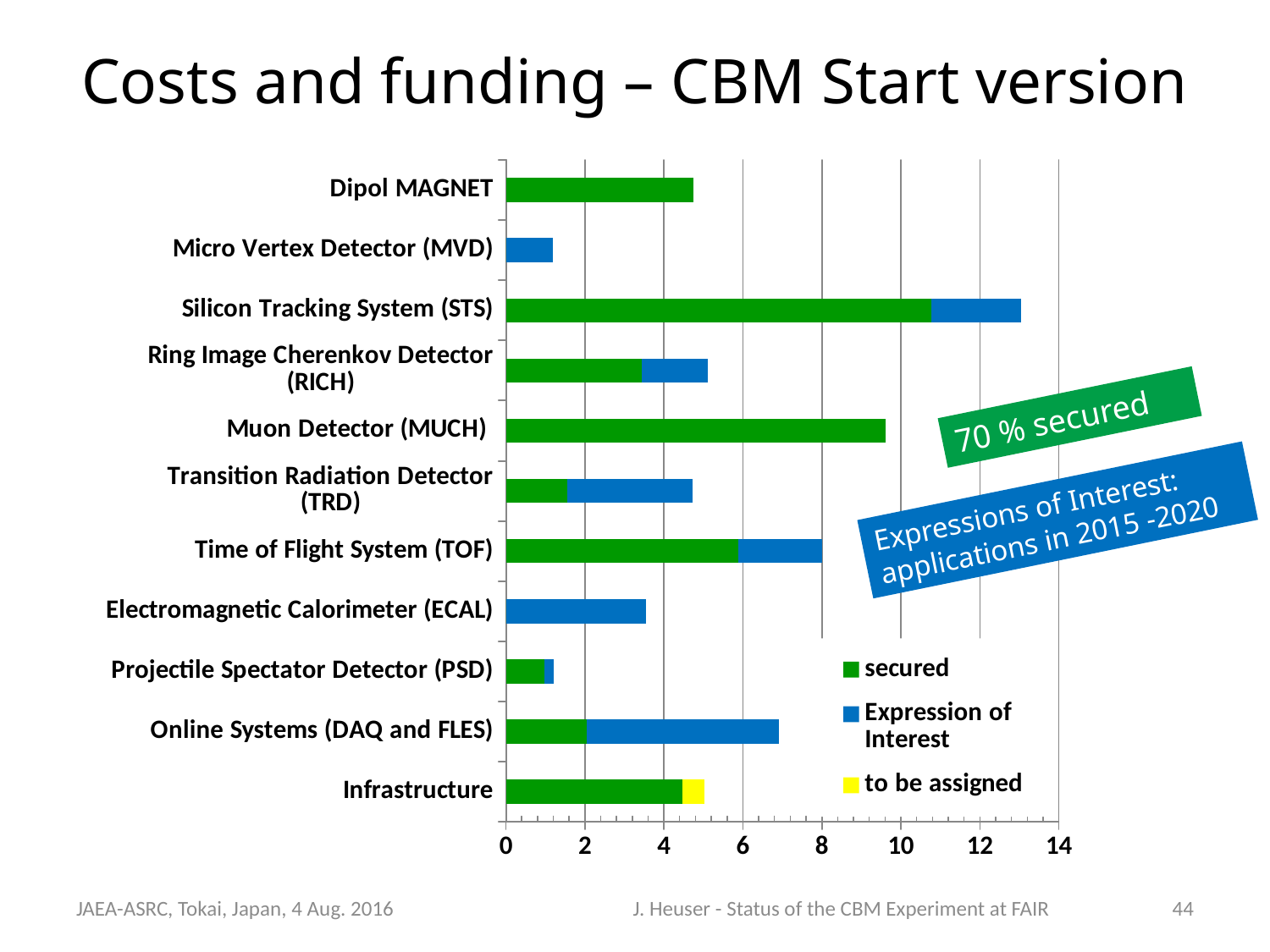
Is the value for Muon Detector (MUCH) greater or less than 8? greater Is the value for Electromagnetic Calorimeter (ECAL) greater or less than 4? less Is the value for Micro Vertex Detector (MVD) greater or less than 2? less Which category is the only one with a 'to be assigned' (yellow) segment? Infrastructure Which category has the longest total bar? Silicon Tracking System (STS) How many categories (detector systems) are listed on the chart? 11 Which series is shown in green in the legend? secured Which has the longer total bar, Muon Detector (MUCH) or Time of Flight System (TOF)? Muon Detector (MUCH) How many series does the chart legend list? 3 What kind of chart is shown on the slide? bar chart